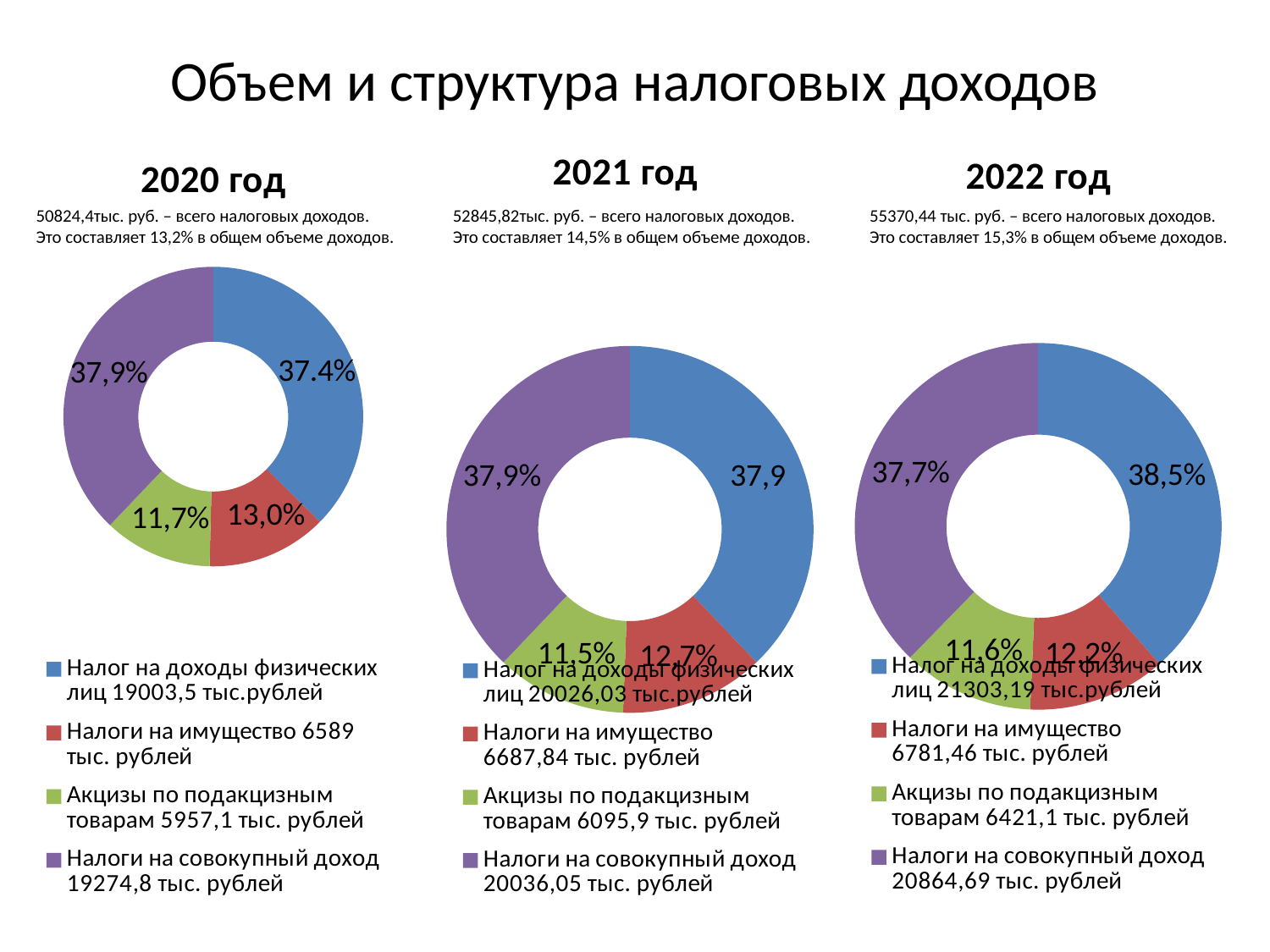
In the 2022 год chart, which category has the smallest share? Акцизы по подакцизным товарам According to the legend of the 2022 год chart, what is the amount for Налоги на совокупный доход? 20864,69 тыс. рублей What is the total tax revenue stated above the 2021 год chart? 52845,82тыс. руб. In the 2021 год chart, what is the difference between the shares for Налоги на имущество and Акцизы по подакцизным товарам? 1,2% How many slices does the 2021 год chart have? 4 What kind of chart is used for the 2020 год chart? Doughnut chart In the 2022 год chart, which is larger: the share for Налог на доходы физических лиц or the share for Налоги на совокупный доход? Налог на доходы физических лиц In the 2020 год chart, what percentage is shown for the blue slice (Налог на доходы физических лиц)? 37.4% In the 2022 год chart, which category has the largest share? Налог на доходы физических лиц In the 2020 год chart, what percentage is shown for Акцизы по подакцизным товарам? 11,7% In the 2022 год chart, what percentage is shown for Налог на доходы физических лиц? 38,5% In the 2021 год chart, what percentage is shown for Налоги на имущество? 12,7%